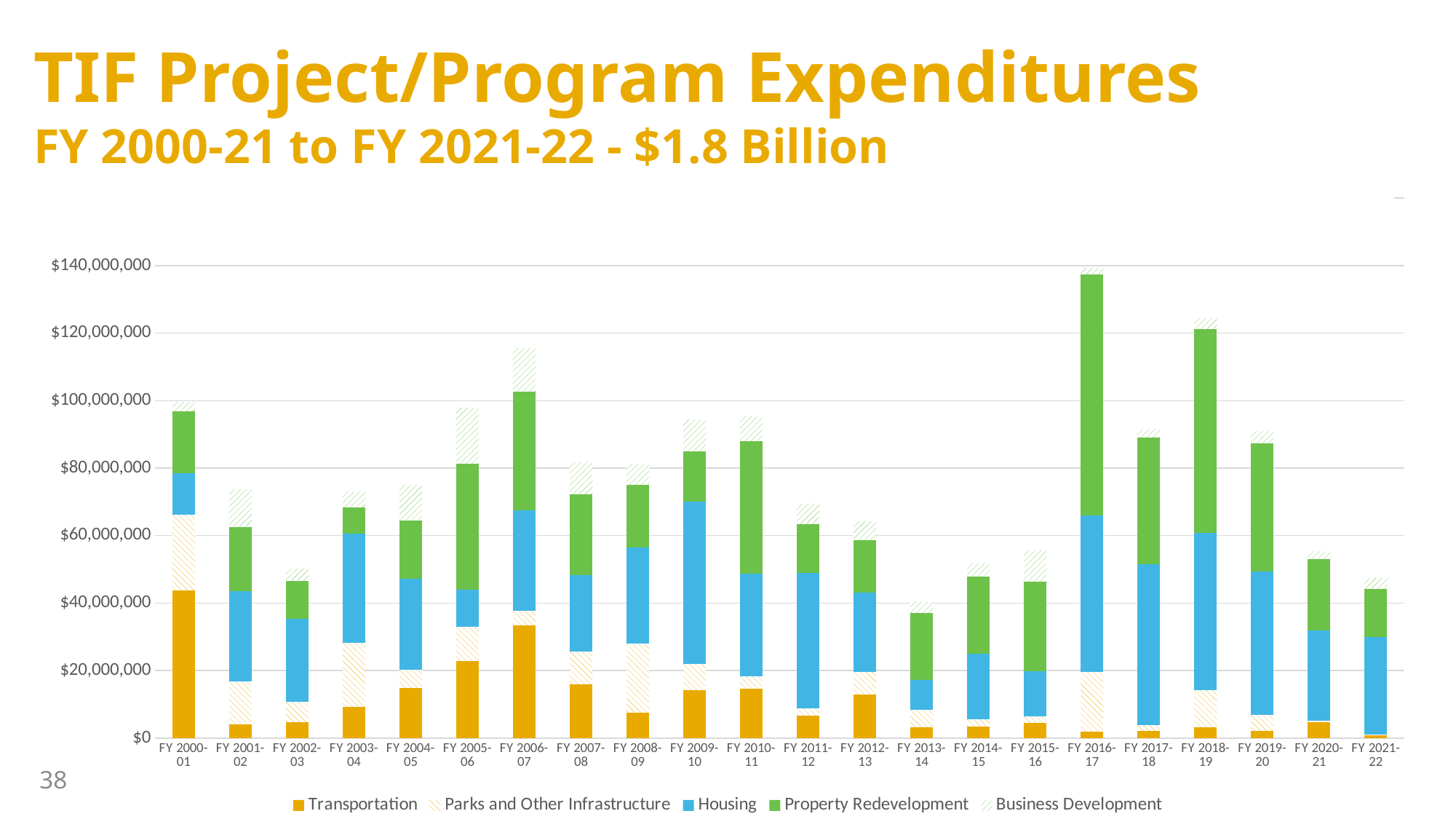
Which fiscal year has the highest total expenditure bar? FY 2016-17 Is the total bar for FY 2002-03 greater or less than $60,000,000? less Which has the taller total bar, FY 2016-17 or FY 2018-19? FY 2016-17 What kind of chart is shown on the slide? Stacked bar chart Is the total bar for FY 2006-07 greater or less than $100,000,000? greater Which fiscal year has the lowest total expenditure bar? FY 2013-14 How many series does the chart's legend list? 5 Which fiscal year has the largest Transportation segment, FY 2000-01 or FY 2006-07? FY 2000-01 Is the total bar for FY 2016-17 greater or less than $120,000,000? greater How many fiscal years are shown on the x axis of the chart? 22 Do the total bars rise or fall from FY 2018-19 to FY 2021-22? fall